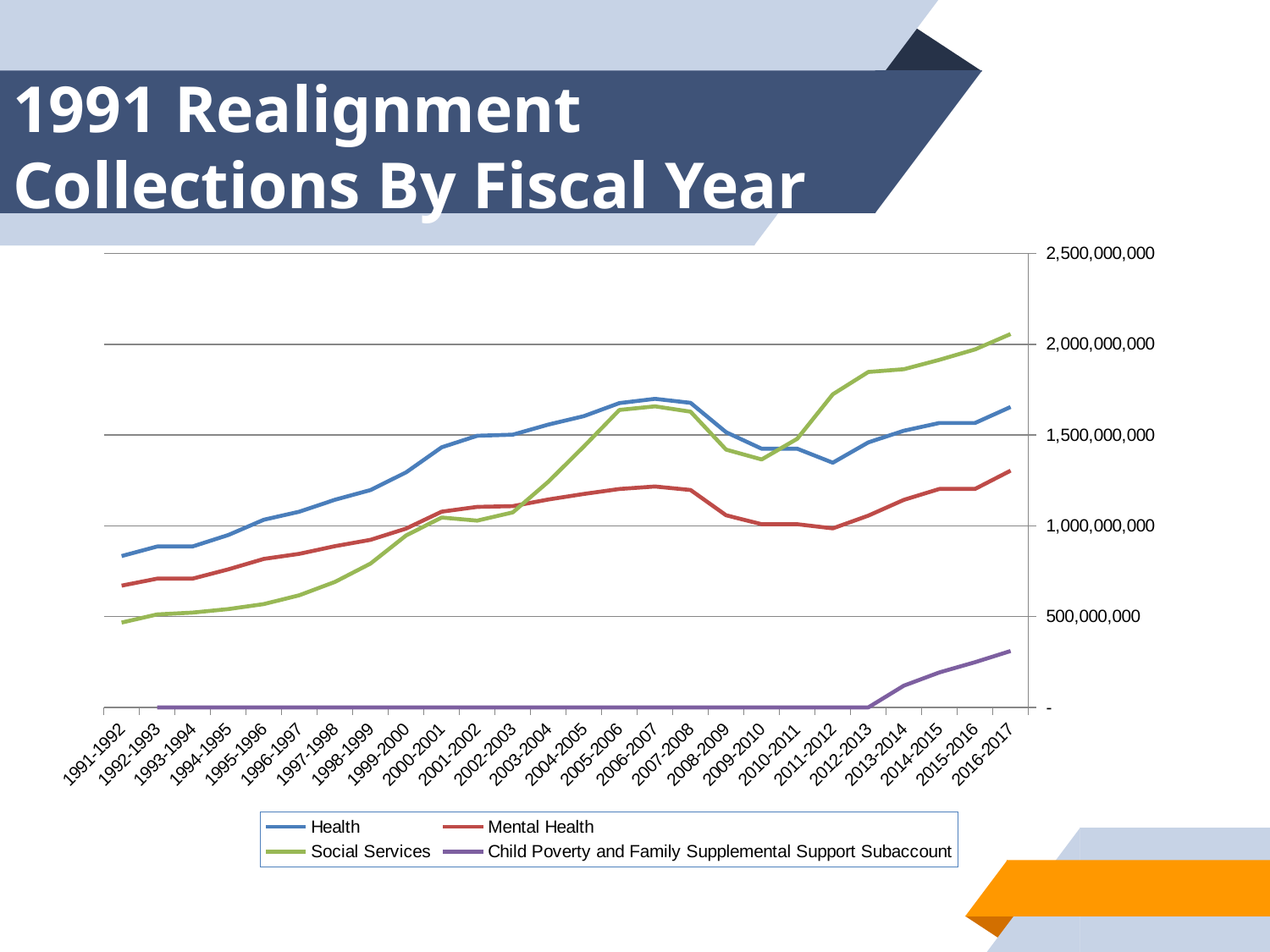
Is the value for Child Poverty and Family Supplemental Support Subaccount in 2016-2017 greater or less than 500,000,000? less Is the value for Health in 1991-1992 greater or less than 1,000,000,000? less Is the value for Mental Health in 2016-2017 greater or less than 1,000,000,000? greater Does the Child Poverty and Family Supplemental Support Subaccount line rise or fall from 2012-2013 to 2016-2017? Rise Which series has the lowest value in 2016-2017? Child Poverty and Family Supplemental Support Subaccount What kind of chart is shown on the slide? Line chart Which series has the highest value in 2016-2017? Social Services What is the title of the slide? 1991 Realignment Collections By Fiscal Year How many series does the legend list? 4 Which series has the highest value in 1991-1992? Health How many fiscal years are plotted along the x axis? 26 In 2016-2017, which is larger: Health or Mental Health? Health